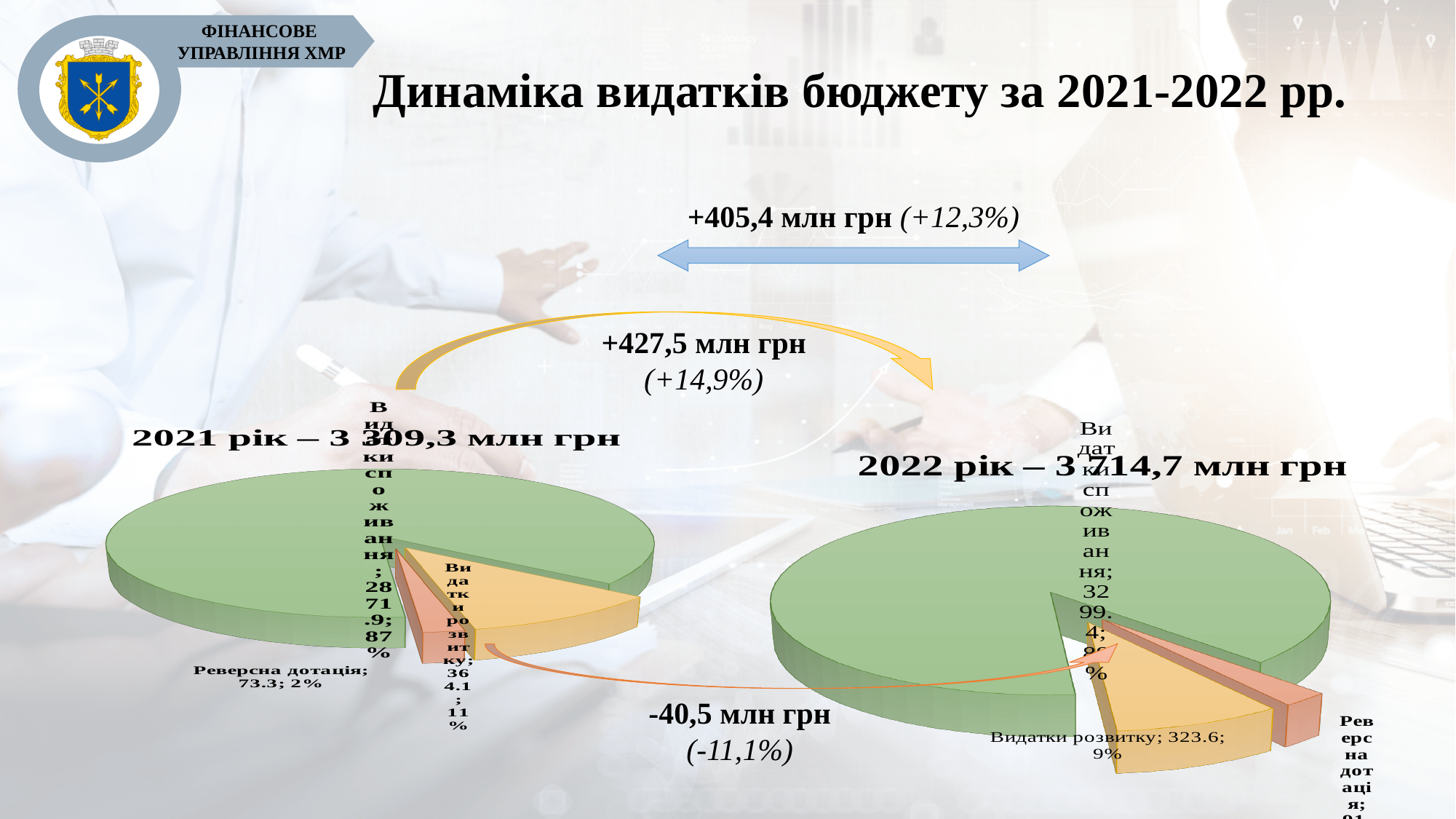
In the 2021 chart, which category has the largest slice? Видатки споживання In the 2022 chart (2022 рік – 3 714,7 млн грн), what is the value for Видатки розвитку? 323.6 In the 2021 chart, what share of the pie is Реверсна дотація? 2% In the 2021 chart (2021 рік – 3 309,3 млн грн), what is the value for Видатки розвитку? 364.1 In the 2021 chart, which category has the smallest slice? Реверсна дотація What kind of chart is used to show the 2021 budget expenditures? Pie chart In the 2022 chart, which category has the largest slice? Видатки споживання In the 2022 chart, what share of the pie is Видатки розвитку? 9% In the 2021 chart, what share of the pie is Видатки споживання? 87% How many slices does the 2021 pie chart have? 3 What is the difference between the Видатки розвитку value in the 2021 chart and in the 2022 chart? 40.5 In the 2021 chart, what is the value for Реверсна дотація? 73.3